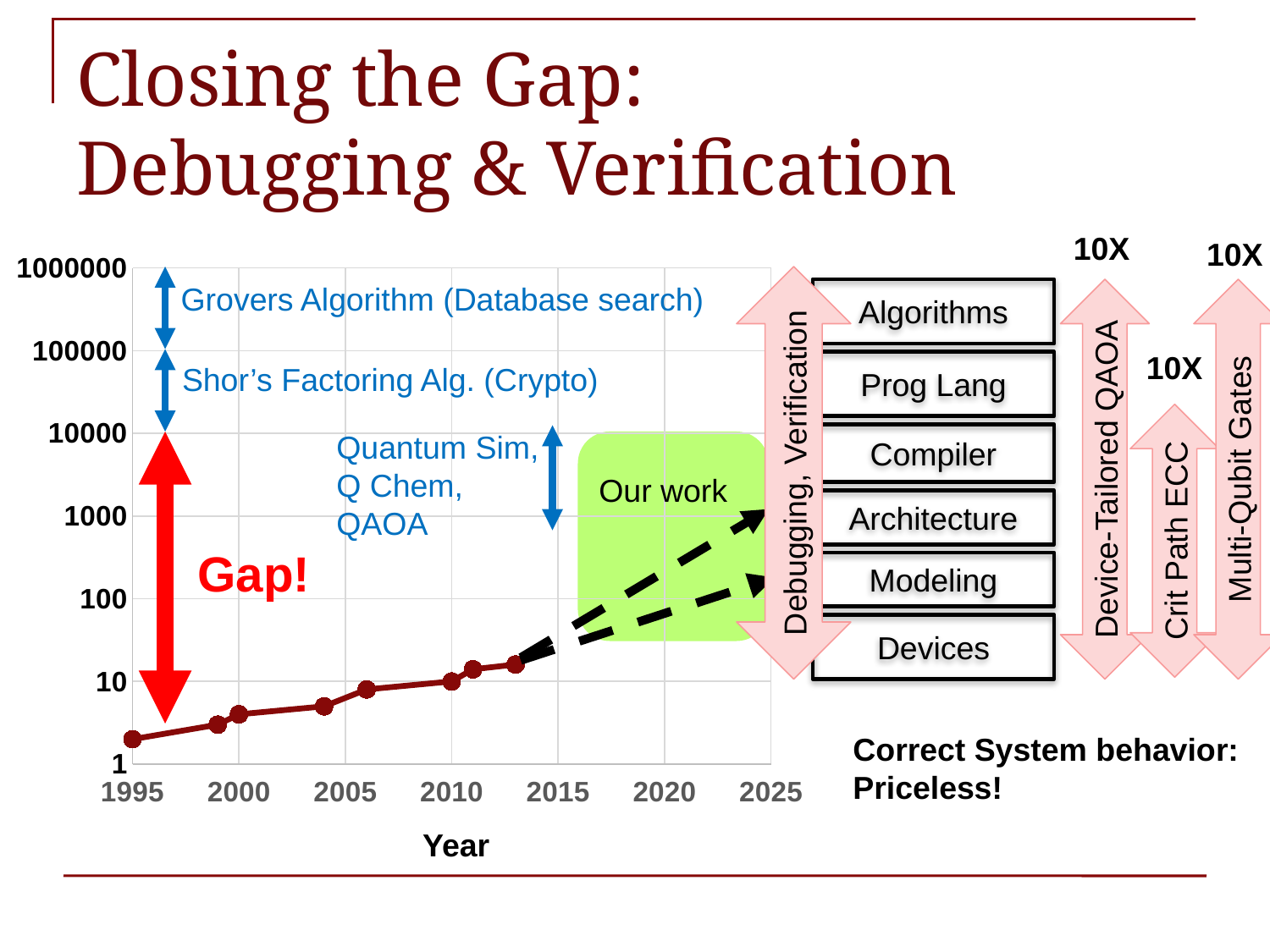
How many data points are plotted on the line? 8 Which year has the lowest plotted value on the chart? 1995 Do the plotted values rise or fall as the year increases along the x axis? rise What is the label of the x axis of the chart? Year What is the last year labelled on the x axis of the chart? 2025 Is the plotted value for the last data point (around 2013) greater or less than 100? less What kind of chart is shown on the left of the slide? line chart What is the highest tick value shown on the y axis of the chart? 1000000 Is the plotted value for the last data point (around 2013) greater or less than 10? greater Is the plotted value for 1995 greater or less than 10? less Which plotted point is higher: the one at 1995 or the one at 2013? 2013